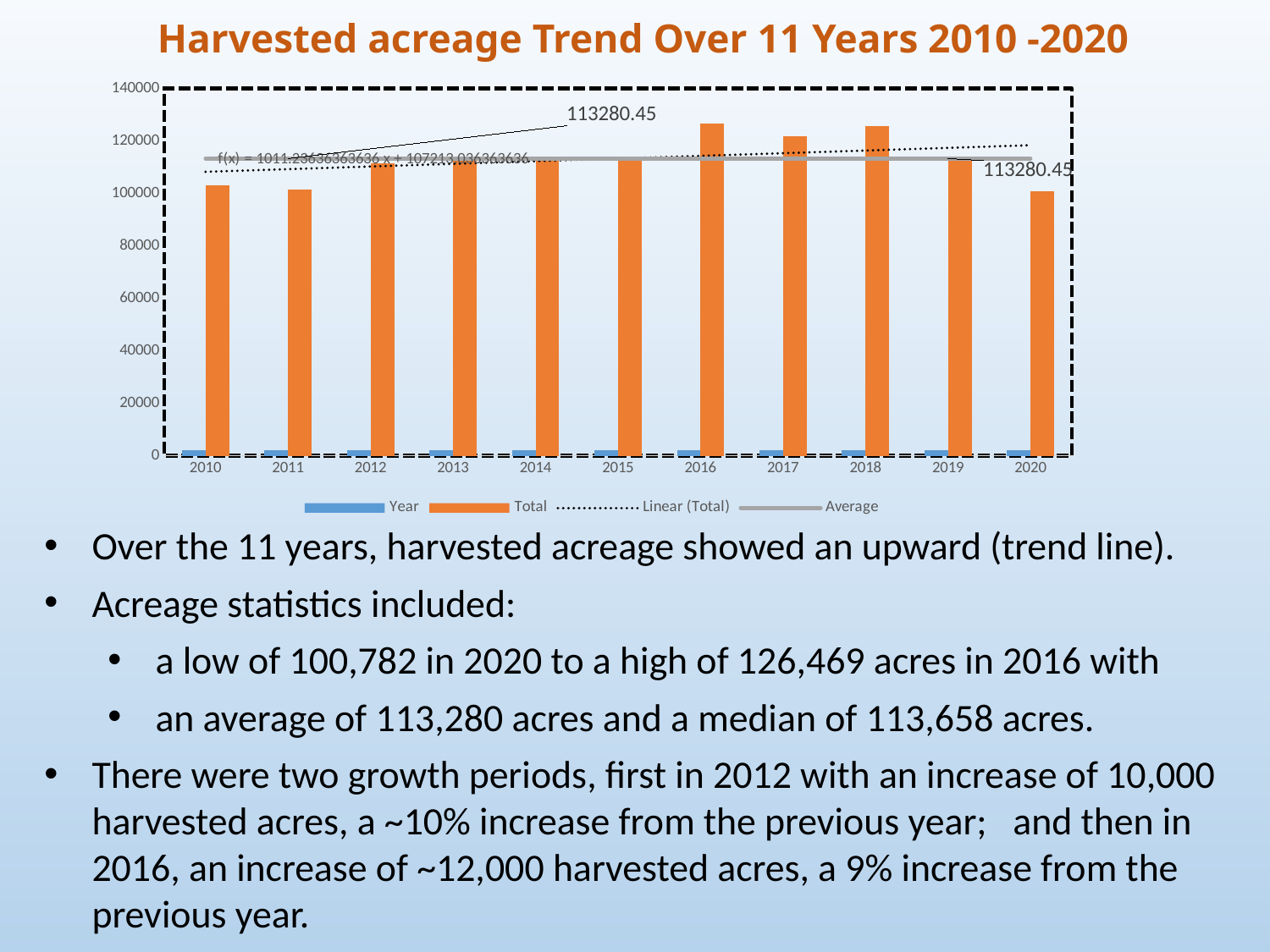
What is the title of the chart? Harvested acreage Trend Over 11 Years 2010 -2020 What kind of chart is shown on the slide? combination bar and line chart How many years are shown on the x axis of the chart? 11 Which year has the highest Total bar? 2016 According to the Linear (Total) trend line, do the Total values rise or fall from 2010 to 2020? rise Is the Total value for 2020 greater or less than 80000? greater How many entries does the chart legend list? 4 Is the Total value for 2016 greater or less than 120000? greater Which year has the larger Total bar, 2016 or 2010? 2016 Is the Total value for 2010 greater or less than 120000? less What value is labelled on the Average line in the chart? 113280.45 Which year has the larger Total bar, 2012 or 2011? 2012